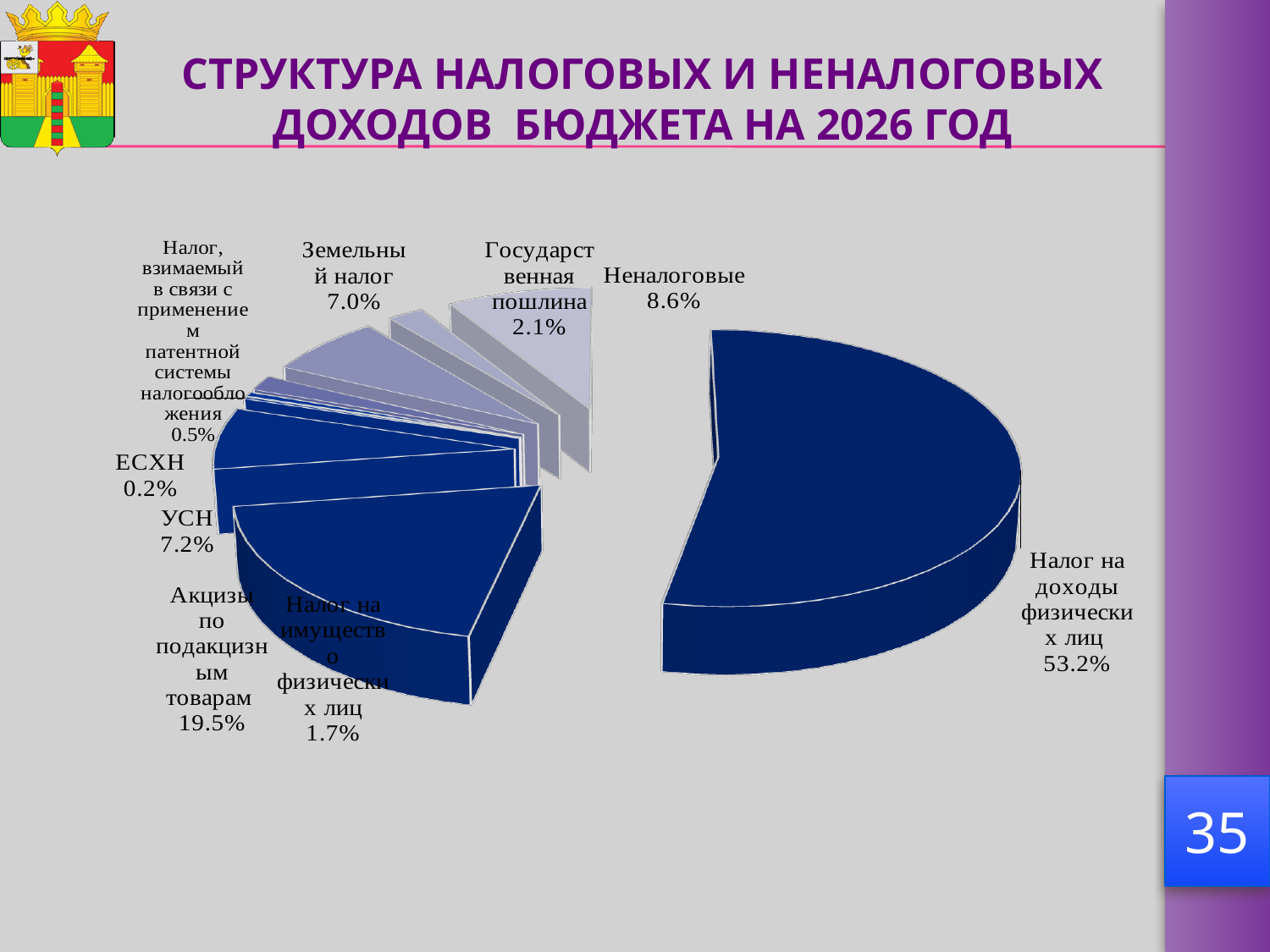
What share of the pie does "Налог на доходы физических лиц" have? 53.2% How many slices does the pie chart have? 9 What is the value shown for "Акцизы по подакцизным товарам"? 19.5% Which category has the smallest share of the pie? ЕСХН Which is larger, the share of "Неналоговые" or the share of "УСН"? Неналоговые What kind of chart is shown on the slide? Pie chart What is the value shown for "Земельный налог"? 7.0% What is the difference between the shares of "УСН" and "Земельный налог"? 0.2% Which category has the largest share of the pie? Налог на доходы физических лиц What is the value shown for "Государственная пошлина"? 2.1% What is the value shown for "Неналоговые"? 8.6% What is the title of the slide containing the chart? СТРУКТУРА НАЛОГОВЫХ И НЕНАЛОГОВЫХ ДОХОДОВ БЮДЖЕТА НА 2026 ГОД